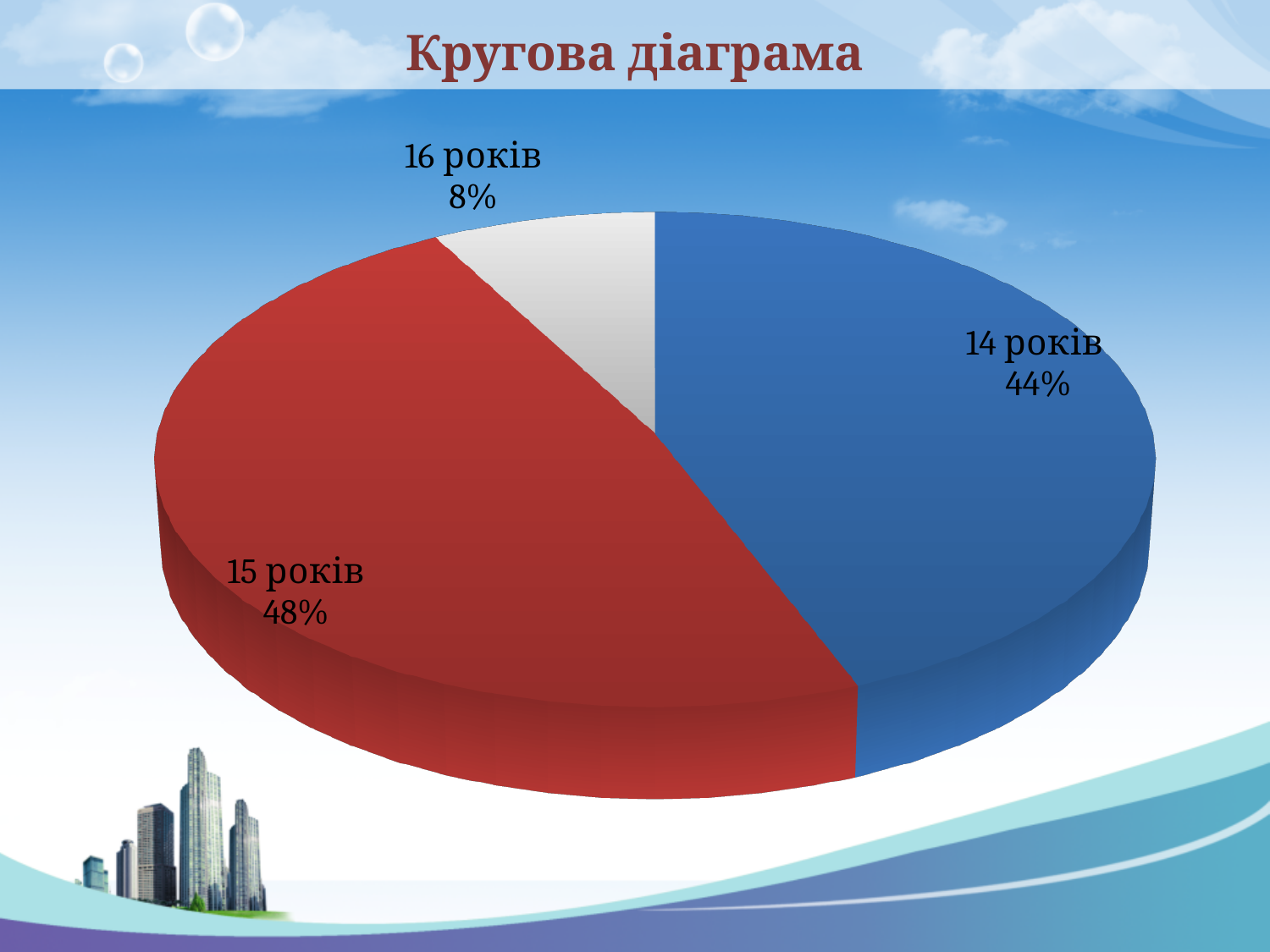
Which category has the largest slice of the pie? 15 років Which category has the smallest slice of the pie? 16 років Which slice is larger, "14 років" or "16 років"? 14 років What is the difference in percentage points between the "15 років" and "14 років" slices? 4% What share of the pie does the "16 років" slice represent? 8% What is the difference in percentage points between the "14 років" and "16 років" slices? 36% What kind of chart is shown on the slide? pie chart What share of the pie does the "14 років" slice represent? 44% What colour is the "15 років" slice of the pie? red What share of the pie does the "15 років" slice represent? 48% How many slices does the pie chart have? 3 What is the title of the slide containing the pie chart? Кругова діаграма